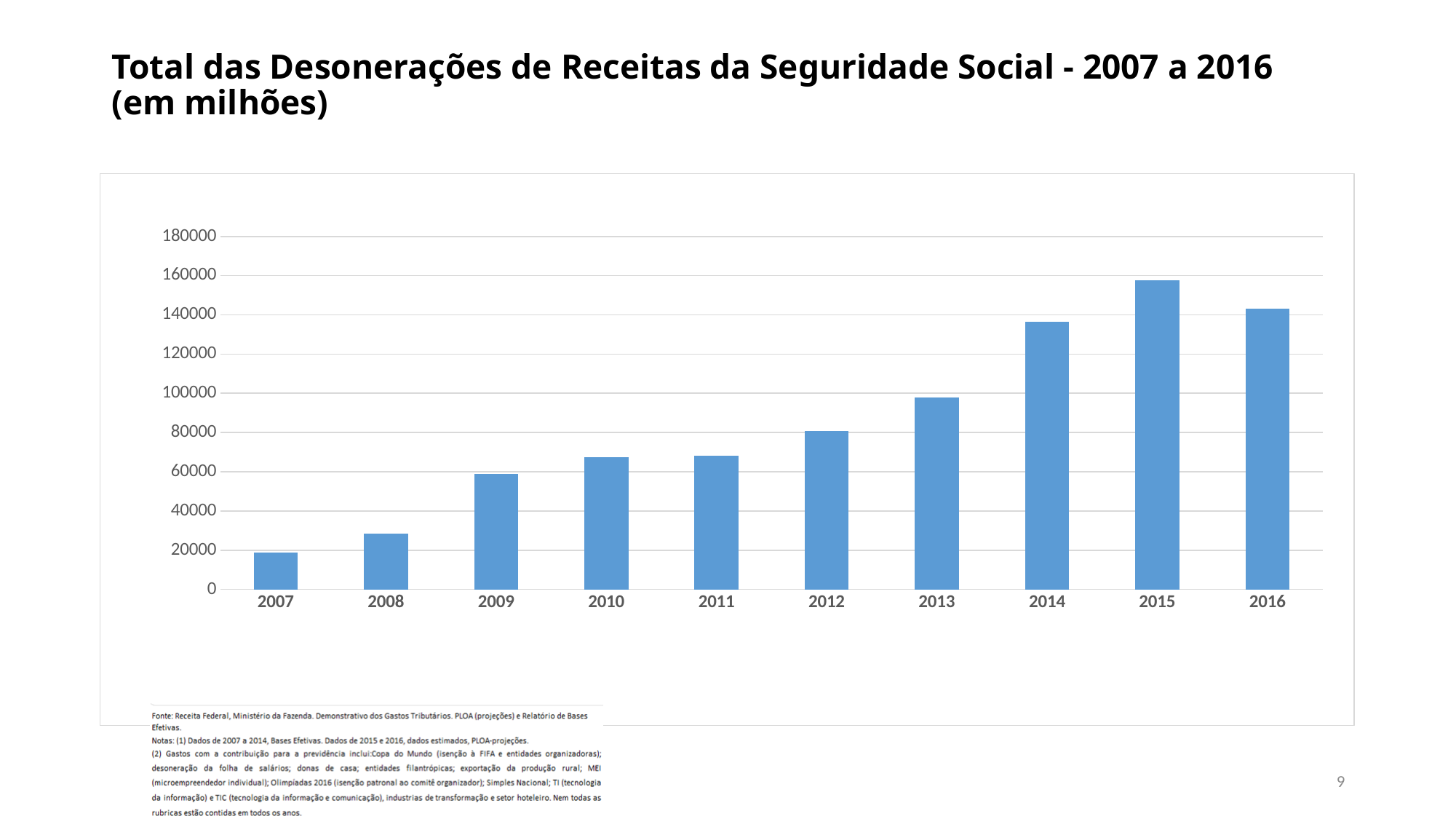
Which is larger, the value for 2016 or the value for 2014? 2016 How many years are shown on the x axis of the chart? 10 What is the title of the chart on the slide? Total das Desonerações de Receitas da Seguridade Social - 2007 a 2016 (em milhões) What kind of chart is shown on the slide? bar chart Is the value for 2013 greater or less than 100000? less Which is larger, the value for 2009 or the value for 2012? 2012 Do the values generally rise or fall from 2007 to 2015? rise Is the value for 2014 greater or less than 120000? greater Is the value for 2015 greater or less than 140000? greater Which year has the highest value in the chart? 2015 Which year has the lowest value in the chart? 2007